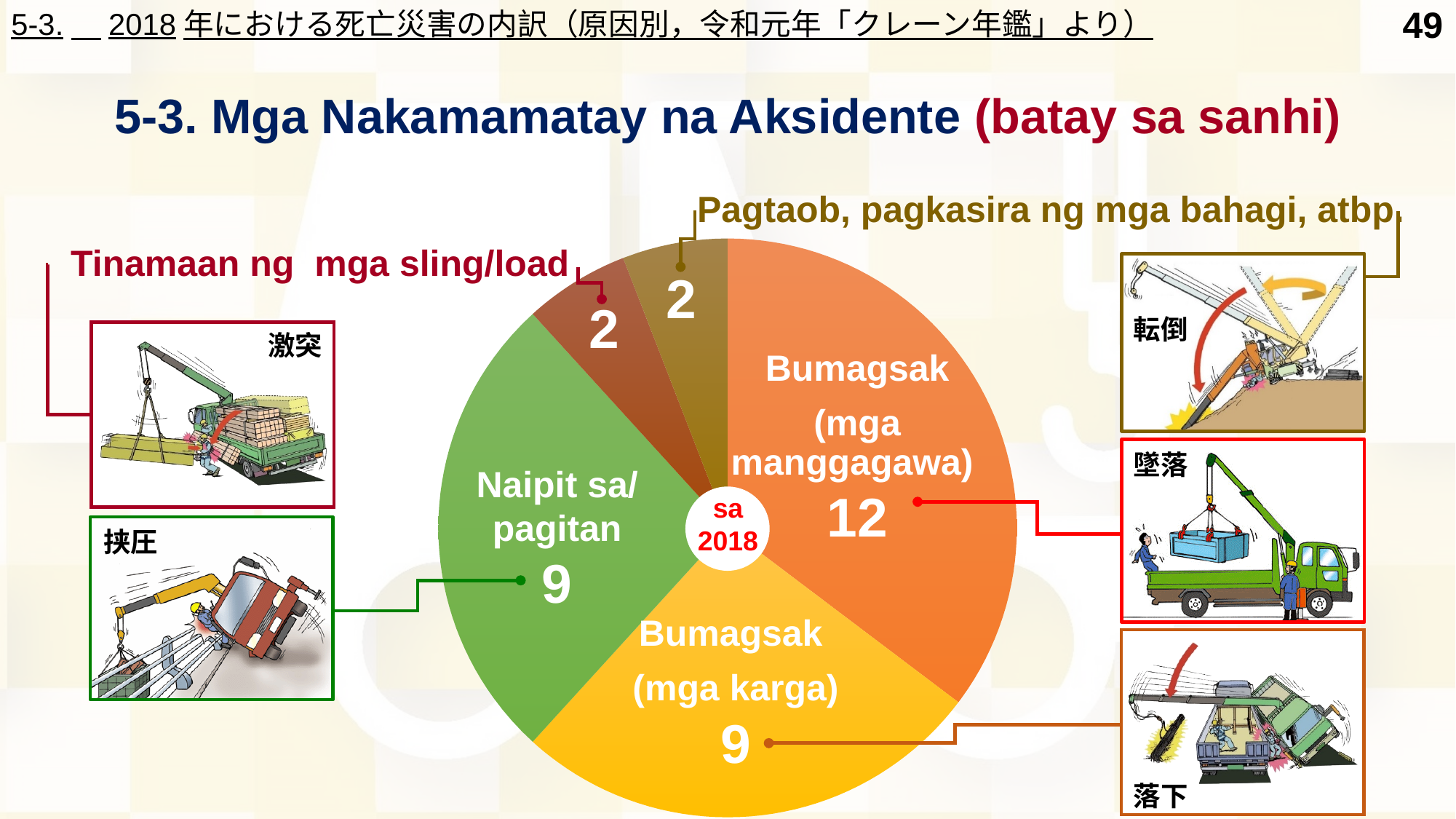
What is the value for Naipit sa/pagitan? 9 What is the value for Tinamaan ng mga sling/load? 2 How many slices does the pie chart have? 5 What is the value for Bumagsak (mga karga)? 9 What kind of chart is shown on the slide? pie chart What is the value for Bumagsak (mga manggagawa)? 12 Which category has the highest value in the pie chart? Bumagsak (mga manggagawa) Which is larger, Bumagsak (mga manggagawa) or Bumagsak (mga karga)? Bumagsak (mga manggagawa) What year is written in the centre of the pie chart? 2018 What is the difference between Bumagsak (mga karga) and Tinamaan ng mga sling/load? 7 What is the value for Pagtaob, pagkasira ng mga bahagi, atbp.? 2 What is the difference between Bumagsak (mga manggagawa) and Naipit sa/pagitan? 3